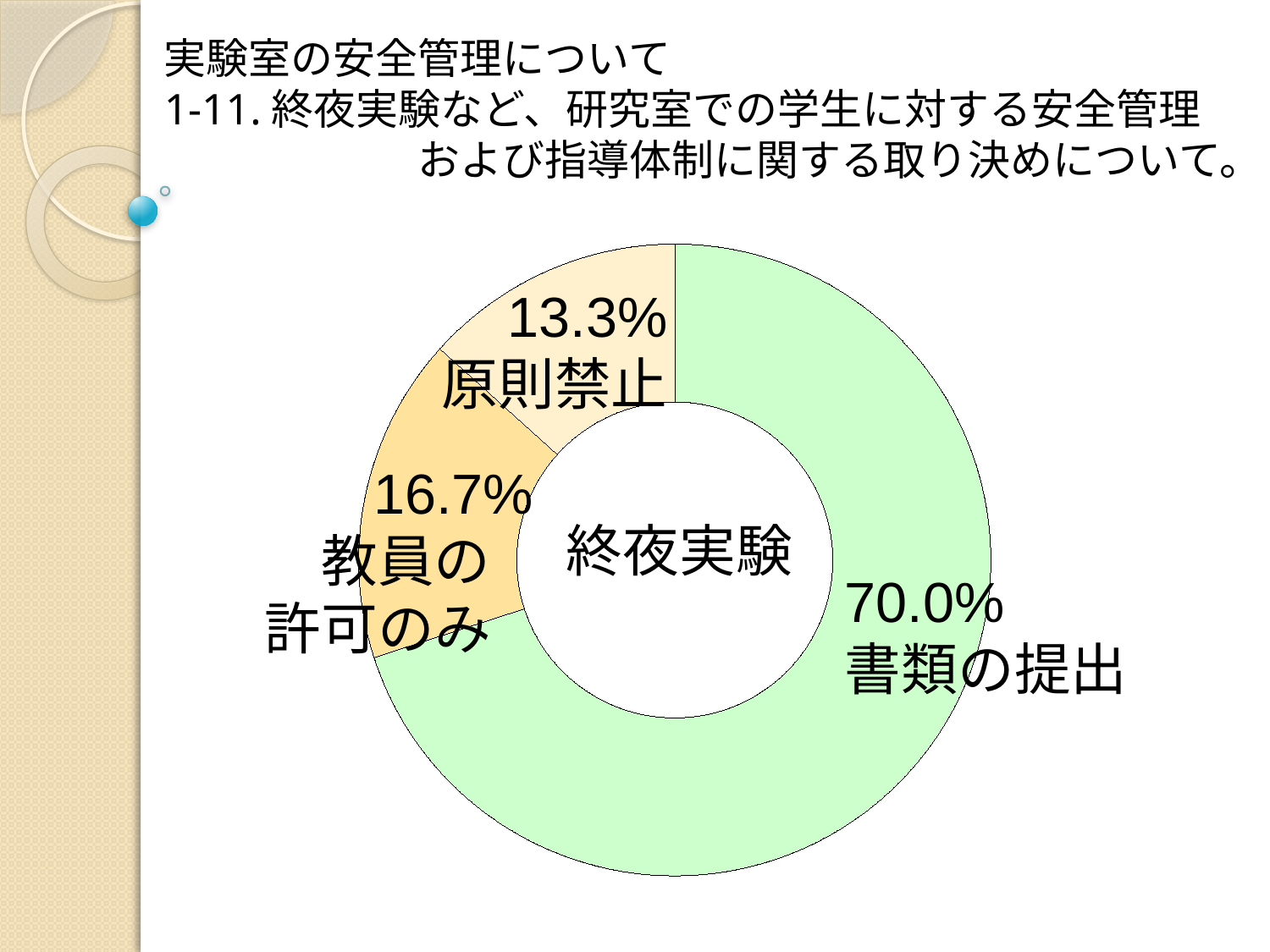
What is the value shown for 教員の許可のみ? 16.7% Which is larger, the share for 教員の許可のみ or the share for 原則禁止? 教員の許可のみ What is the difference in percentage points between 書類の提出 and 教員の許可のみ? 53.3 What colour is the 書類の提出 segment? Light green What kind of chart is shown on the slide? Doughnut chart How many categories are shown in the chart? 3 Which category has the smallest share of the chart? 原則禁止 What share of the doughnut chart does 書類の提出 represent? 70.0% Which category has the largest share of the chart? 書類の提出 What is the value shown for 原則禁止? 13.3% What label appears in the centre of the doughnut chart? 終夜実験 What is the difference in percentage points between 教員の許可のみ and 原則禁止? 3.4